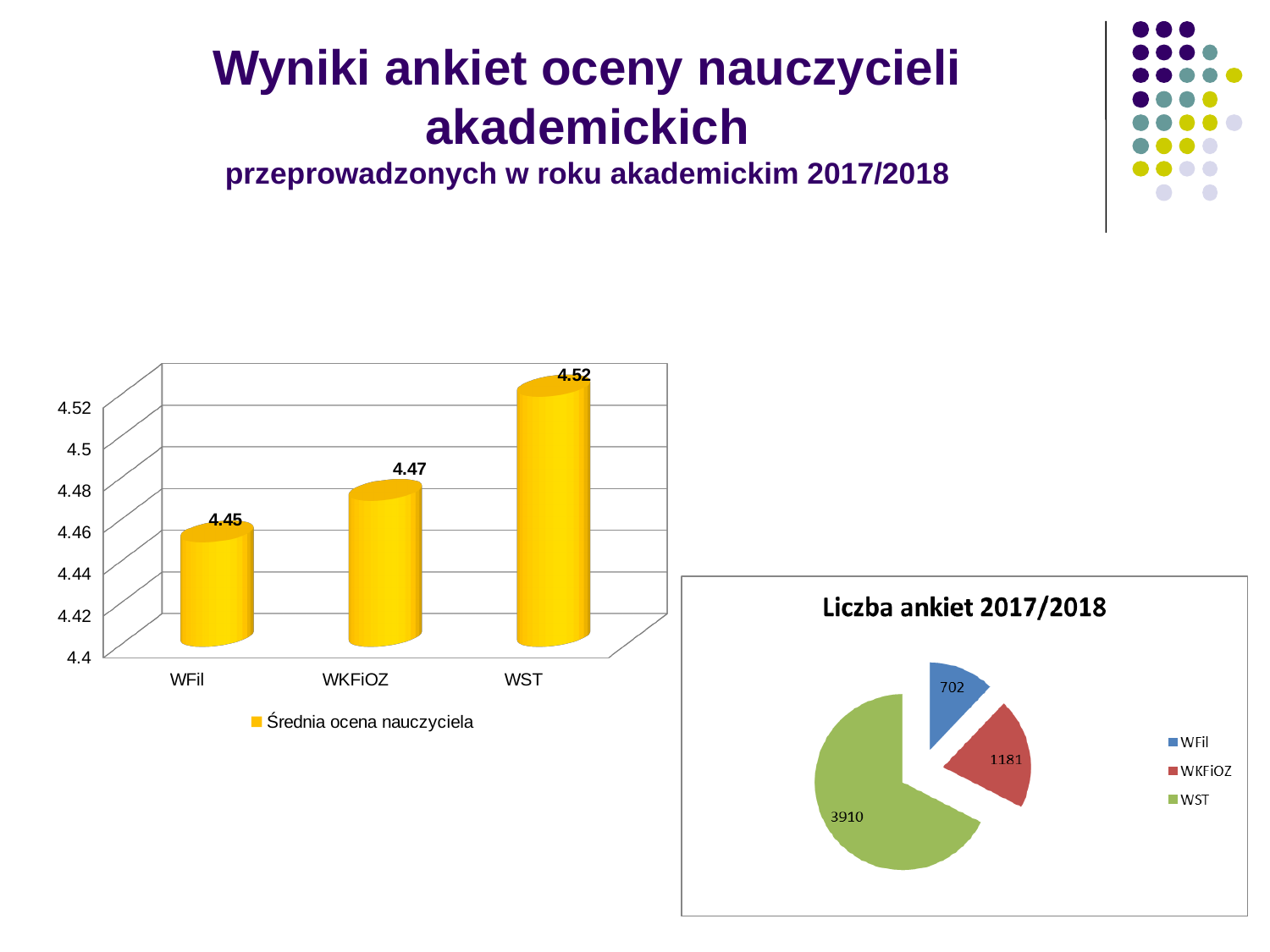
In the bar chart on the left, what series name does the legend show? Średnia ocena nauczyciela In the bar chart on the left, which category has the lowest value? WFil In the bar chart on the left, what is the difference between the values for WST and WKFiOZ? 0.05 In the chart titled 'Liczba ankiet 2017/2018', what is the difference between the values for WST and WFil? 3208 What kind of chart is the chart titled 'Liczba ankiet 2017/2018'? pie chart How many categories does the chart titled 'Liczba ankiet 2017/2018' show? 3 In the bar chart on the left, what is the value for WST? 4.52 In the chart titled 'Liczba ankiet 2017/2018', which category has the largest slice? WST In the bar chart on the left, do the values rise or fall from WFil to WST? rise In the bar chart on the left, what is the value for WFil? 4.45 In the chart titled 'Liczba ankiet 2017/2018', what is the value for WKFiOZ? 1181 In the bar chart on the left, which category has the highest value? WST